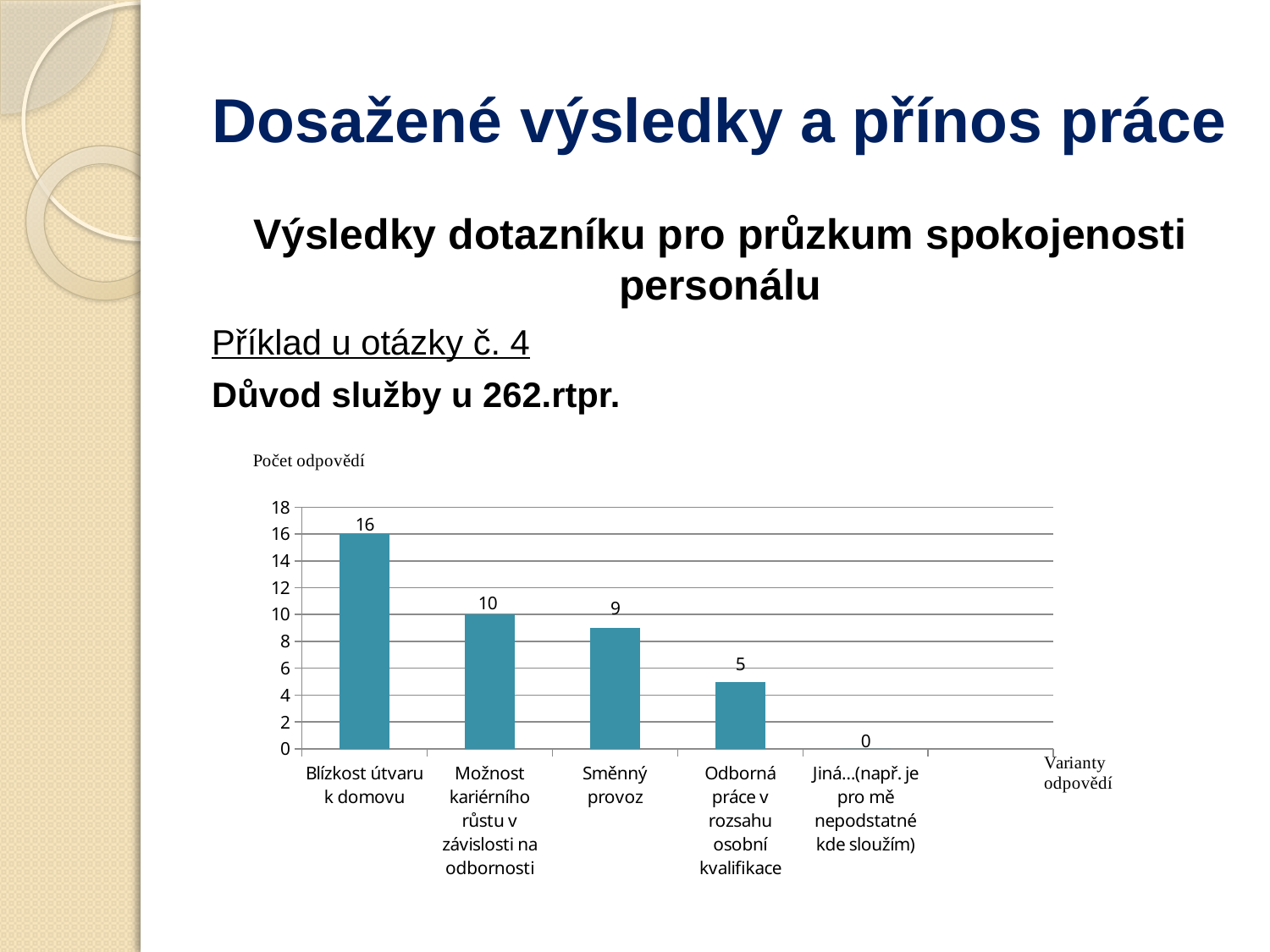
What is the value for "Blízkost útvaru k domovu"? 16 What is the difference between the values for "Blízkost útvaru k domovu" and "Možnost kariérního růstu v závislosti na odbornosti"? 6 What kind of chart is shown on the slide? bar chart Which category has the lowest value? Jiná...(např. je pro mě nepodstatné kde sloužím) What is the label of the vertical axis? Počet odpovědí Which is larger, the value for "Možnost kariérního růstu v závislosti na odbornosti" or the value for "Směnný provoz"? Možnost kariérního růstu v závislosti na odbornosti What is the value for "Směnný provoz"? 9 Which category has the highest value? Blízkost útvaru k domovu How many categories are shown on the x axis? 5 What is the value for "Odborná práce v rozsahu osobní kvalifikace"? 5 What is the value for "Jiná...(např. je pro mě nepodstatné kde sloužím)"? 0 Is the value for "Odborná práce v rozsahu osobní kvalifikace" greater or less than 6? less